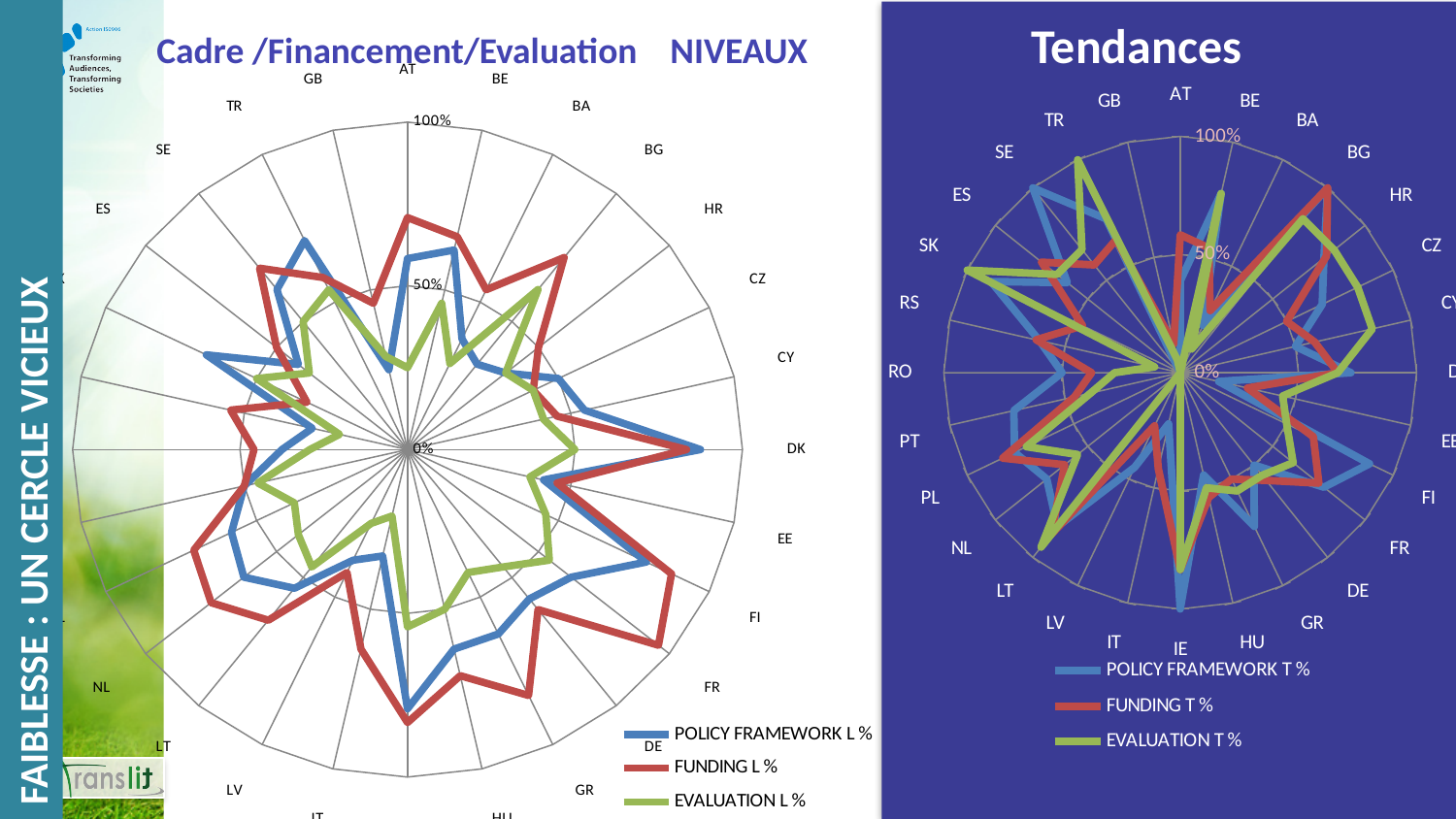
In the left chart (Cadre /Financement/Evaluation NIVEAUX), is the FUNDING L % value for DK greater or less than 50%? greater What is the title of the chart on the right side of the slide? Tendances How many series does the legend of the left chart (Cadre /Financement/Evaluation NIVEAUX) list? 3 In the 'Tendances' chart, is the EVALUATION T % value for IE greater or less than 50%? greater In the left chart (Cadre /Financement/Evaluation NIVEAUX), is the FUNDING L % value for FI greater or less than 50%? greater How many series does the legend of the 'Tendances' chart list? 3 What kind of chart is the chart titled 'Tendances'? radar chart In the left chart (Cadre /Financement/Evaluation NIVEAUX), which is larger for DK: FUNDING L % or EVALUATION L %? FUNDING L % In the 'Tendances' chart, which colour represents the FUNDING T % series? red